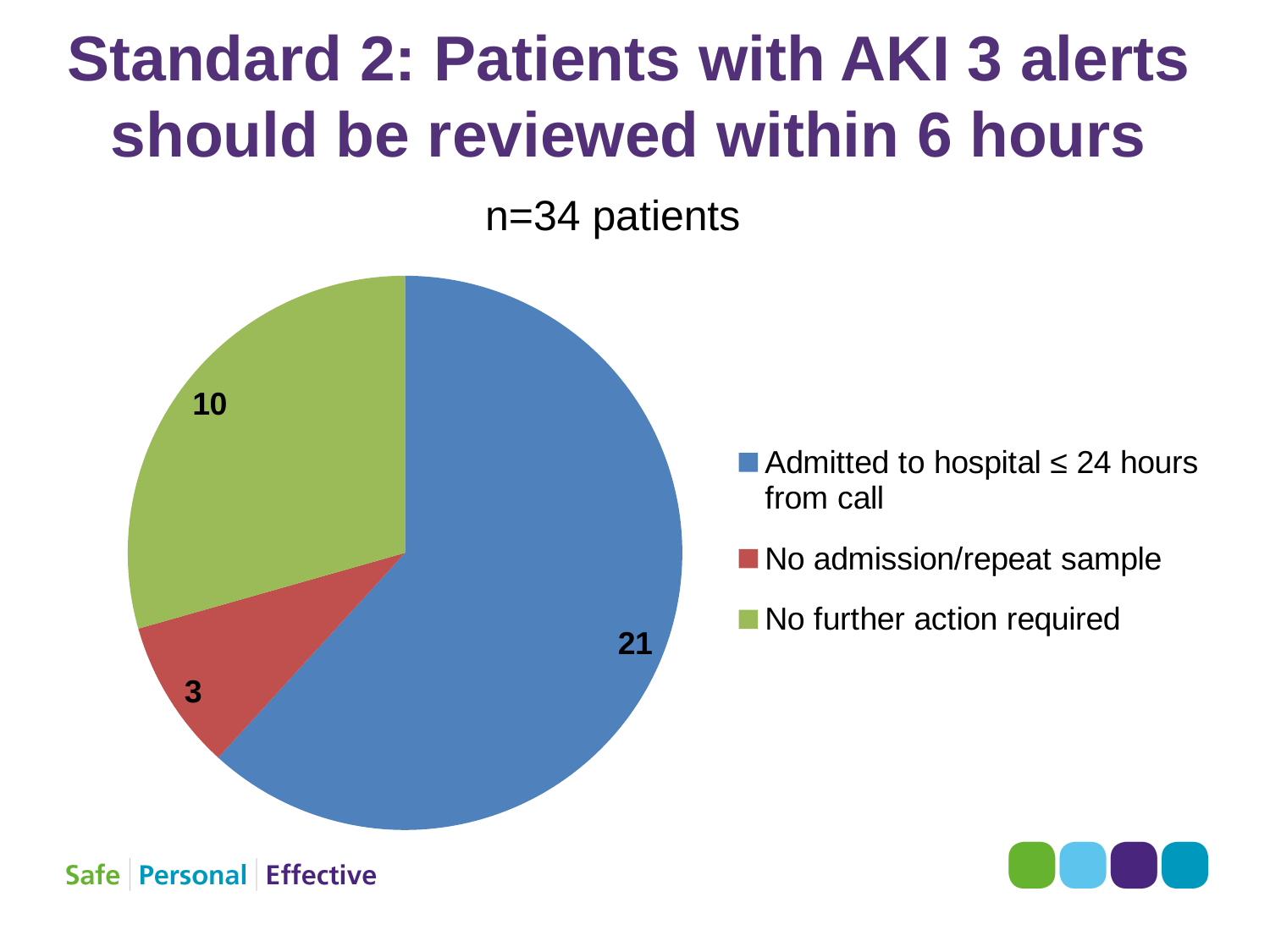
What is the total number of patients across all slices of the pie? 34 How many categories does the pie chart show? 3 How many patients were admitted to hospital ≤ 24 hours from call? 21 Which is larger: the number of patients with no further action required or the number with no admission/repeat sample? No further action required What type of chart is shown on the slide? pie chart What colour is the slice for 'No further action required'? green Which category has the largest slice of the pie? Admitted to hospital ≤ 24 hours from call Which category has the smallest slice of the pie? No admission/repeat sample How many patients had no admission/repeat sample? 3 How many patients required no further action? 10 What is the subtitle shown above the pie chart? n=34 patients What is the difference between the number of patients admitted to hospital ≤ 24 hours from call and the number requiring no further action? 11